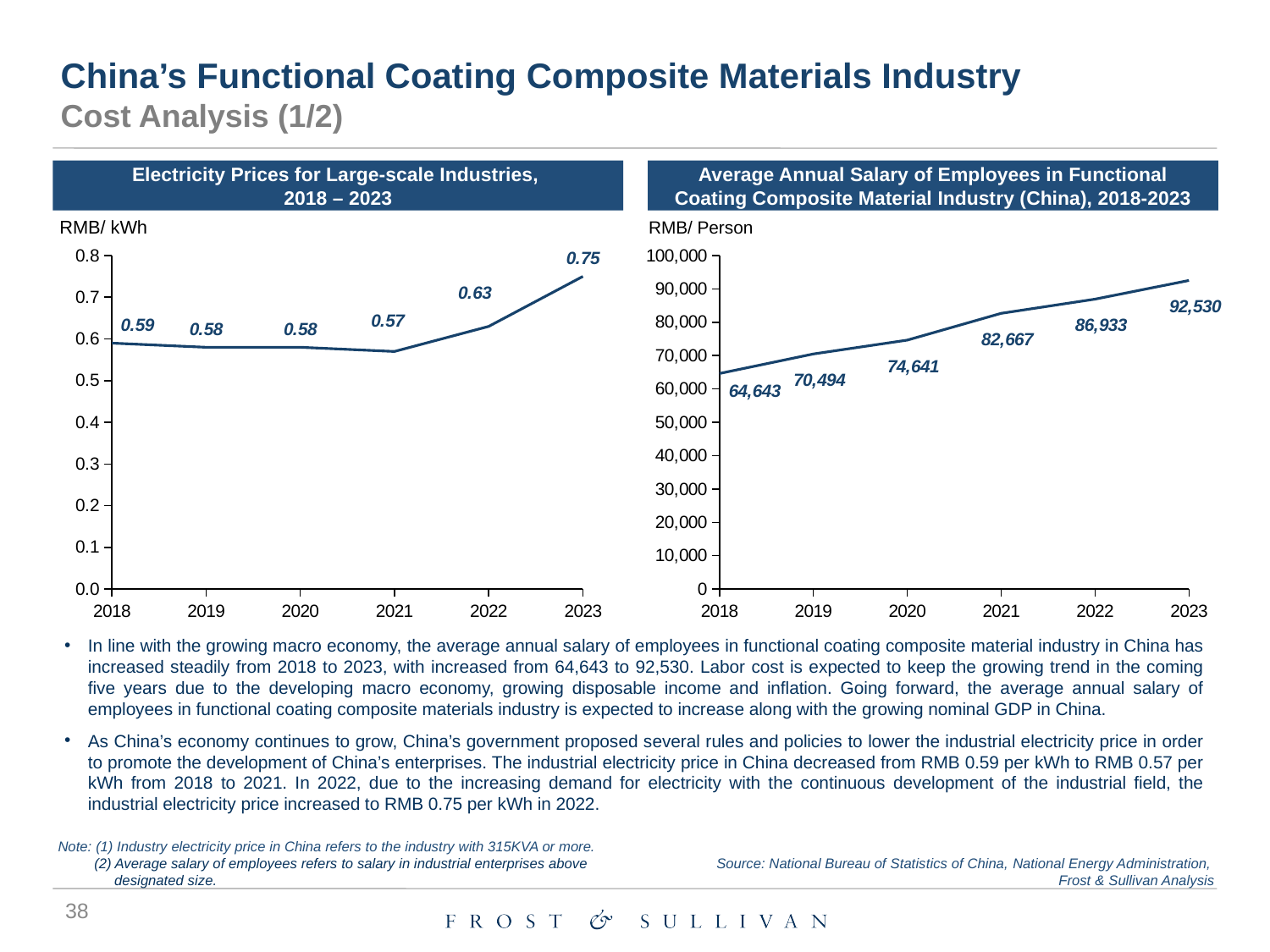
In the Electricity Prices for Large-scale Industries chart, which year has the lowest value? 2021 In the Average Annual Salary chart on the right, what is the difference between the 2023 and 2018 values? 27,887 In the Electricity Prices for Large-scale Industries chart, what is the value for 2021? 0.57 What type of chart is the Electricity Prices for Large-scale Industries chart? Line chart In the Average Annual Salary chart on the right, what is the value for 2020? 74,641 In the Electricity Prices for Large-scale Industries chart, how many years are plotted? 6 In the Electricity Prices for Large-scale Industries chart, which year has the highest value? 2023 In the Average Annual Salary chart on the right, what is the value for 2023? 92,530 In the Average Annual Salary chart on the right, do the values rise or fall from 2018 to 2023? Rise In the Average Annual Salary chart on the right, is the value for 2022 larger than the value for 2021? Yes In the Electricity Prices for Large-scale Industries chart, what is the difference between the 2023 and 2022 values? 0.12 What unit is shown above the y axis of the Average Annual Salary chart on the right? RMB/ Person